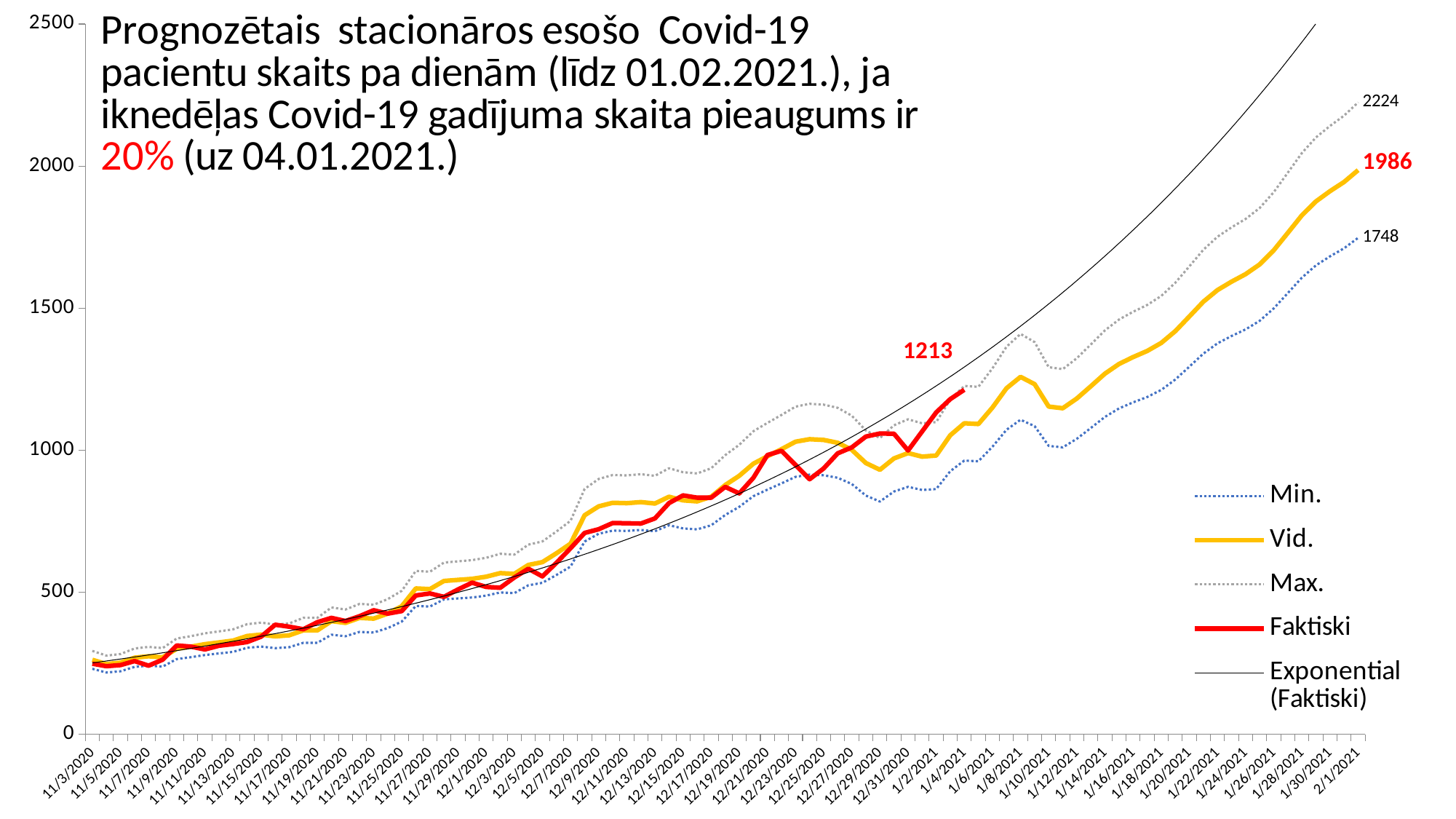
What is the difference between the Max. and Min. values at 2/1/2021? 476 What is the value of the Max. series at 2/1/2021? 2224 What kind of chart is shown on the slide? line chart What is the value of the Min. series at 2/1/2021? 1748 What weekly growth percentage is highlighted in red in the chart title? 20% What is the value of the Vid. series at 2/1/2021? 1986 Is the value of the Exponential (Faktiski) line at 2/1/2021 greater or less than 2000? greater What is the last labelled value of the Faktiski series? 1213 At 2/1/2021, which is larger: the Max. value or the Vid. value? Max. How many series does the legend list? 5 Does the Vid. series generally rise or fall from 11/3/2020 to 2/1/2021? rise What is the difference between the Vid. and Min. values at 2/1/2021? 238